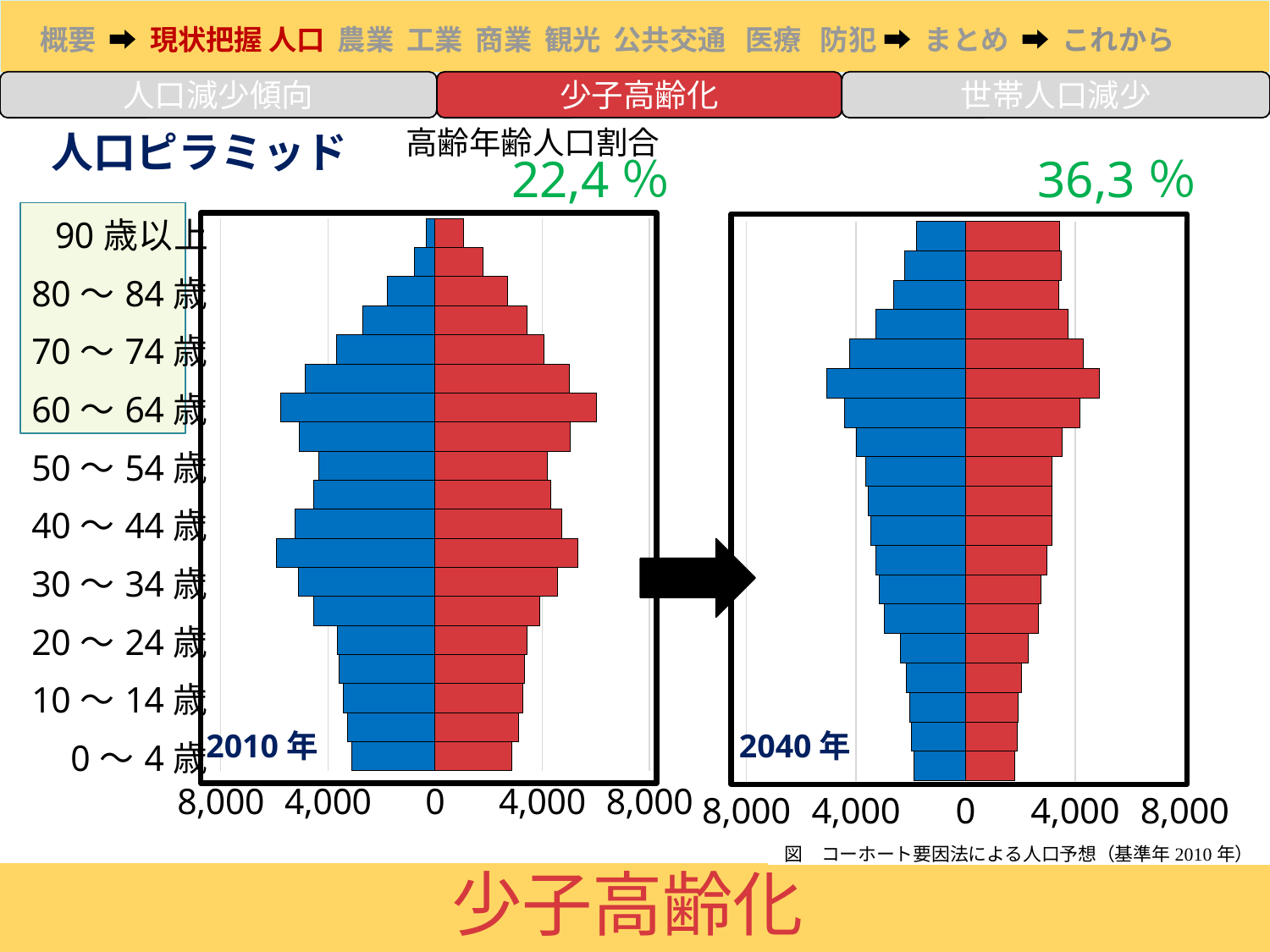
In the 2010年 chart, is the red (right) value for the 0～4歳 group greater or less than 4,000? less By how many percentage points does the 高齢年齢人口割合 for 2040年 exceed that for 2010年? 13,9 % In the 2010年 chart, is the blue (left) value for the 60～64歳 group greater or less than 4,000? greater How many age-group labels are printed along the vertical axis of the population pyramids? 10 What kind of chart is used for the 2010年 and 2040年 population pyramids? bar chart What is the largest value shown on the horizontal axis of each population pyramid? 8,000 In the 2010年 chart, is the red (right) value for the 90歳以上 group greater or less than 4,000? less What is the 高齢年齢人口割合 shown above the 2040年 chart? 36,3 % What is the 高齢年齢人口割合 shown above the 2010年 chart? 22,4 % Which year has the higher 高齢年齢人口割合, 2010年 or 2040年? 2040年 What is the title printed at the top left of the charts? 人口ピラミッド